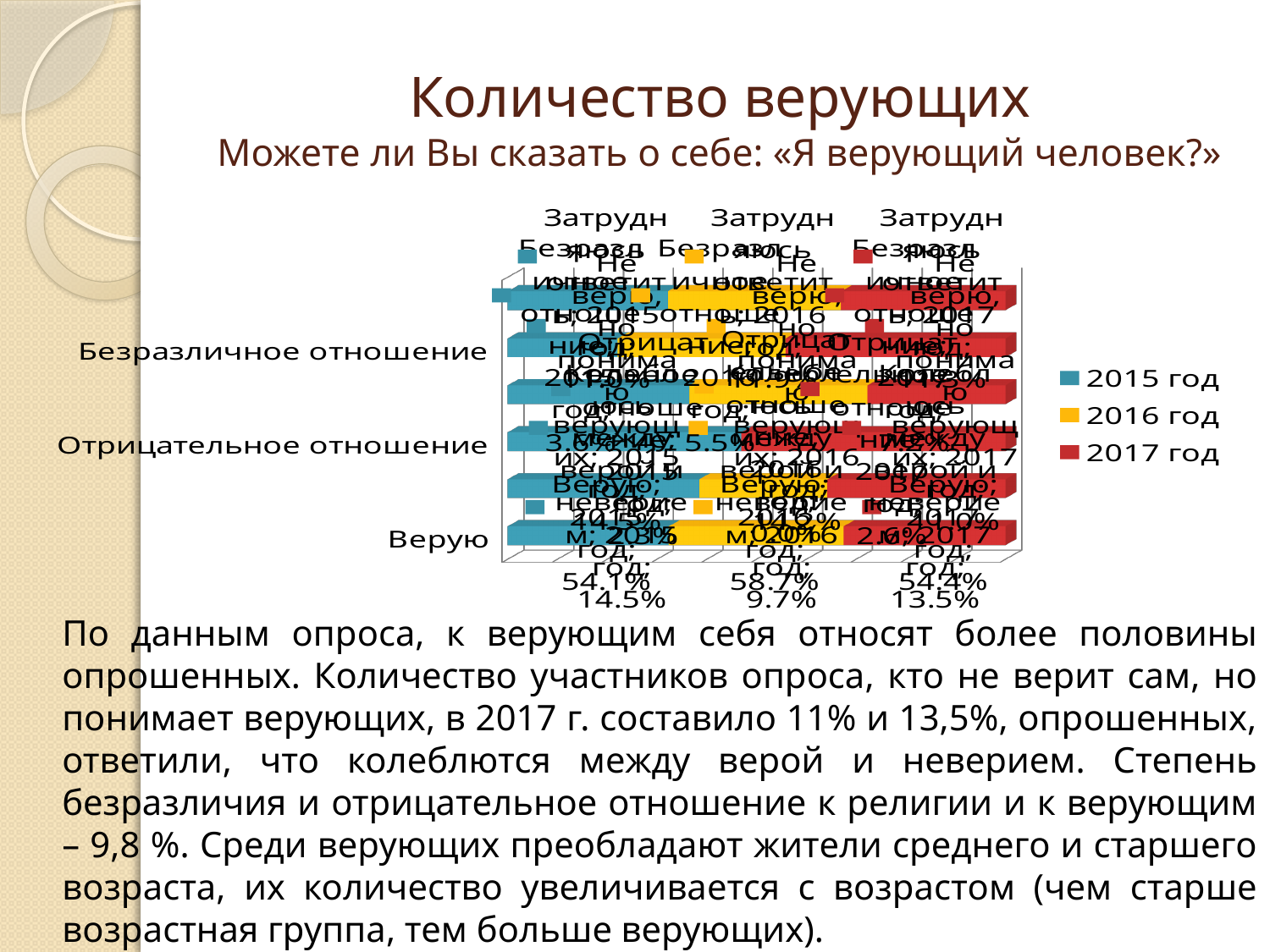
What kind of chart is shown on the slide? bar chart How many series does the chart legend list? 3 What is the difference between the 'Верую' values for 2016 год and 2015 год? 4.6% What is the value for 'Верую' in 2015 год? 54.1% What is the value for 'Верую' in 2016 год? 58.7% Is the value for 'Верую' in 2016 год greater or less than 50%? greater What is the value for 'Верую' in 2017 год? 54.4% In which year was the value for 'Верую' the highest? 2016 год Which years are listed in the chart legend? 2015 год, 2016 год, 2017 год